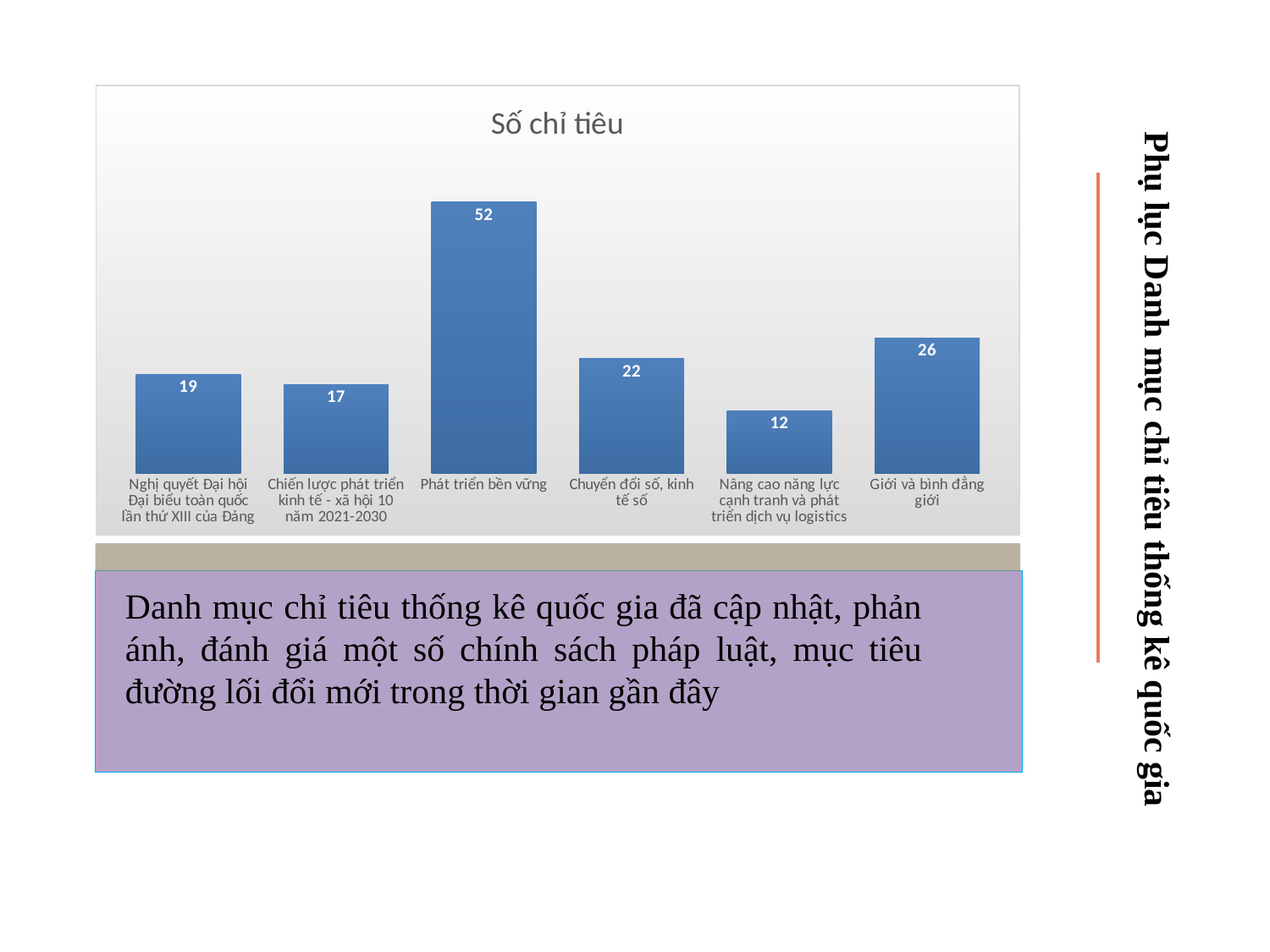
What is the title of the chart? Số chỉ tiêu What is the value for Giới và bình đẳng giới? 26 How many categories are shown in the chart? 6 What is the difference between the values for Phát triển bền vững and Giới và bình đẳng giới? 26 Which category has the highest value? Phát triển bền vững Which category has the lowest value? Nâng cao năng lực cạnh tranh và phát triển dịch vụ logistics What is the value for Chuyển đổi số, kinh tế số? 22 What is the value for Nâng cao năng lực cạnh tranh và phát triển dịch vụ logistics? 12 What is the value for Phát triển bền vững? 52 What is the difference between the values for Nghị quyết Đại hội Đại biểu toàn quốc lần thứ XIII của Đảng and Chiến lược phát triển kinh tế - xã hội 10 năm 2021-2030? 2 Which is larger, the value for Chuyển đổi số, kinh tế số or the value for Giới và bình đẳng giới? Giới và bình đẳng giới What kind of chart is shown on the slide? Bar chart